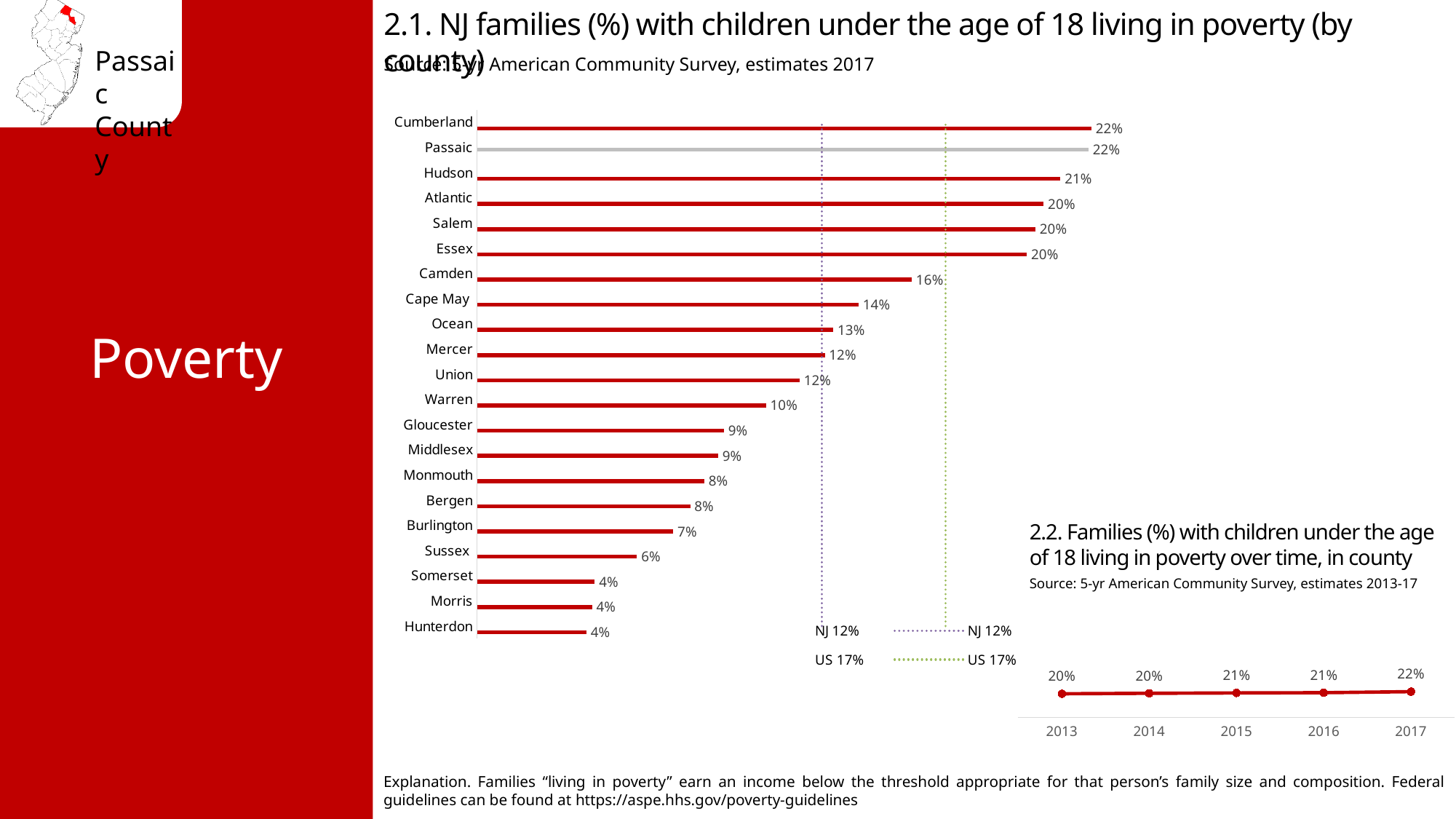
In chart 2.1 (by county), what is the value for Hunterdon? 4% In chart 2.1 (by county), how many counties are shown? 21 In chart 2.1 (NJ families with children under 18 living in poverty by county), what is the value for Passaic? 22% What kind of chart is chart 2.1 (by county)? Bar chart In chart 2.2 (over time), which year has the highest value? 2017 In chart 2.2 (families in poverty over time, in county), what is the value for 2015? 21% In chart 2.1 (by county), what value is shown for the US reference line? 17% In chart 2.1 (by county), what is the value for Camden? 16% In chart 2.2 (over time), do the values rise or fall from 2013 to 2017? Rise In chart 2.1 (by county), what is the difference between the values for Passaic and Bergen? 14% In chart 2.1 (by county), which has the larger value, Hudson or Ocean? Hudson In chart 2.2 (over time), what is the difference between the values for 2017 and 2013? 2%